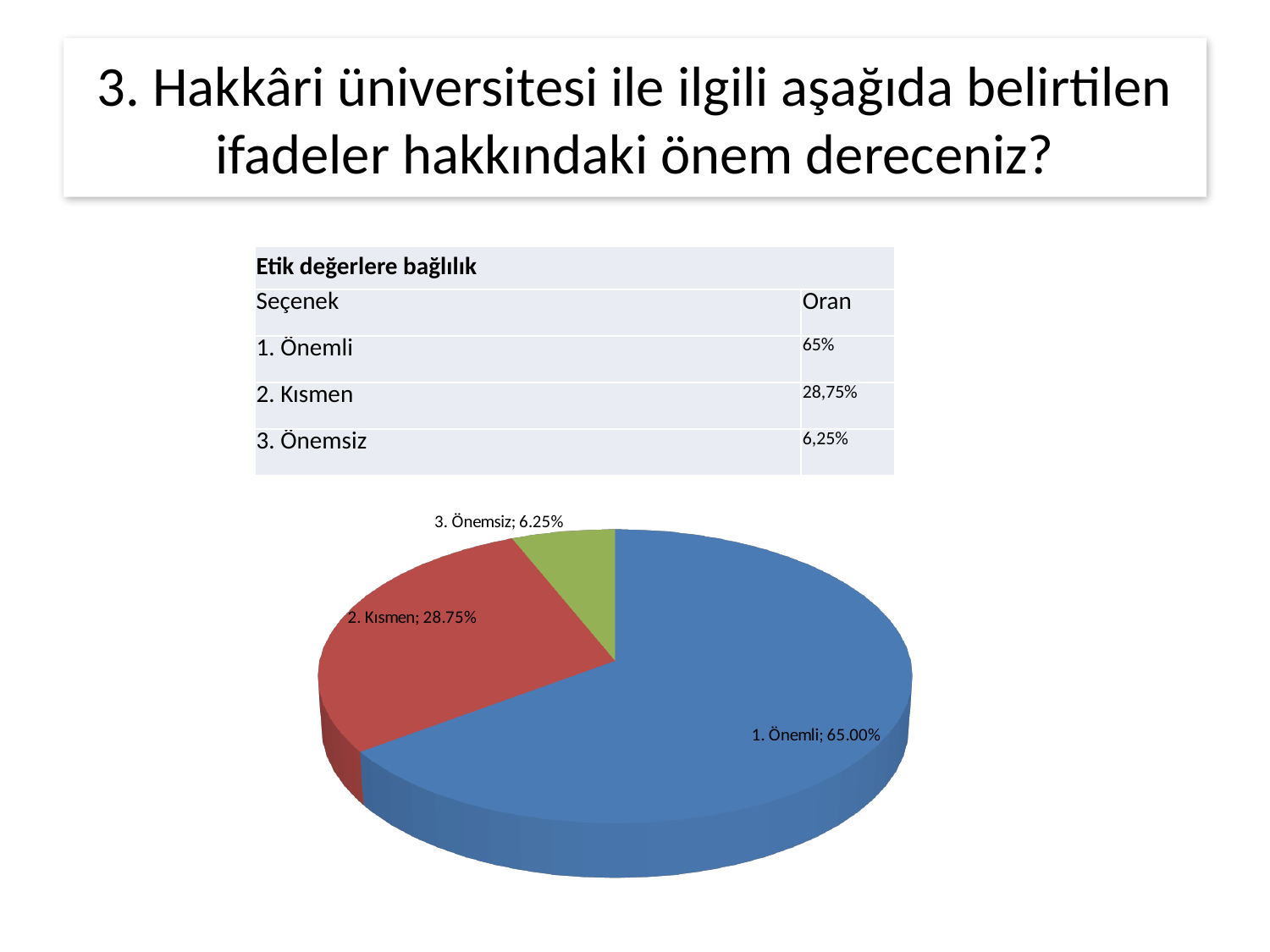
What colour is the "1. Önemli" slice in the pie chart? Blue What percentage does the pie chart show for "3. Önemsiz"? 6.25% How many slices does the pie chart have? 3 Which category has the largest slice in the pie chart? 1. Önemli What colour is the "3. Önemsiz" slice in the pie chart? Green What percentage does the pie chart show for "2. Kısmen"? 28.75% Which category has the smallest slice in the pie chart? 3. Önemsiz What is the difference between the "2. Kısmen" and "3. Önemsiz" percentages in the pie chart? 22.50% What is the difference between the "1. Önemli" and "2. Kısmen" percentages in the pie chart? 36.25% What type of chart is shown on the slide? Pie chart What percentage does the pie chart show for "1. Önemli"? 65.00% Which is larger in the pie chart, "2. Kısmen" or "3. Önemsiz"? 2. Kısmen